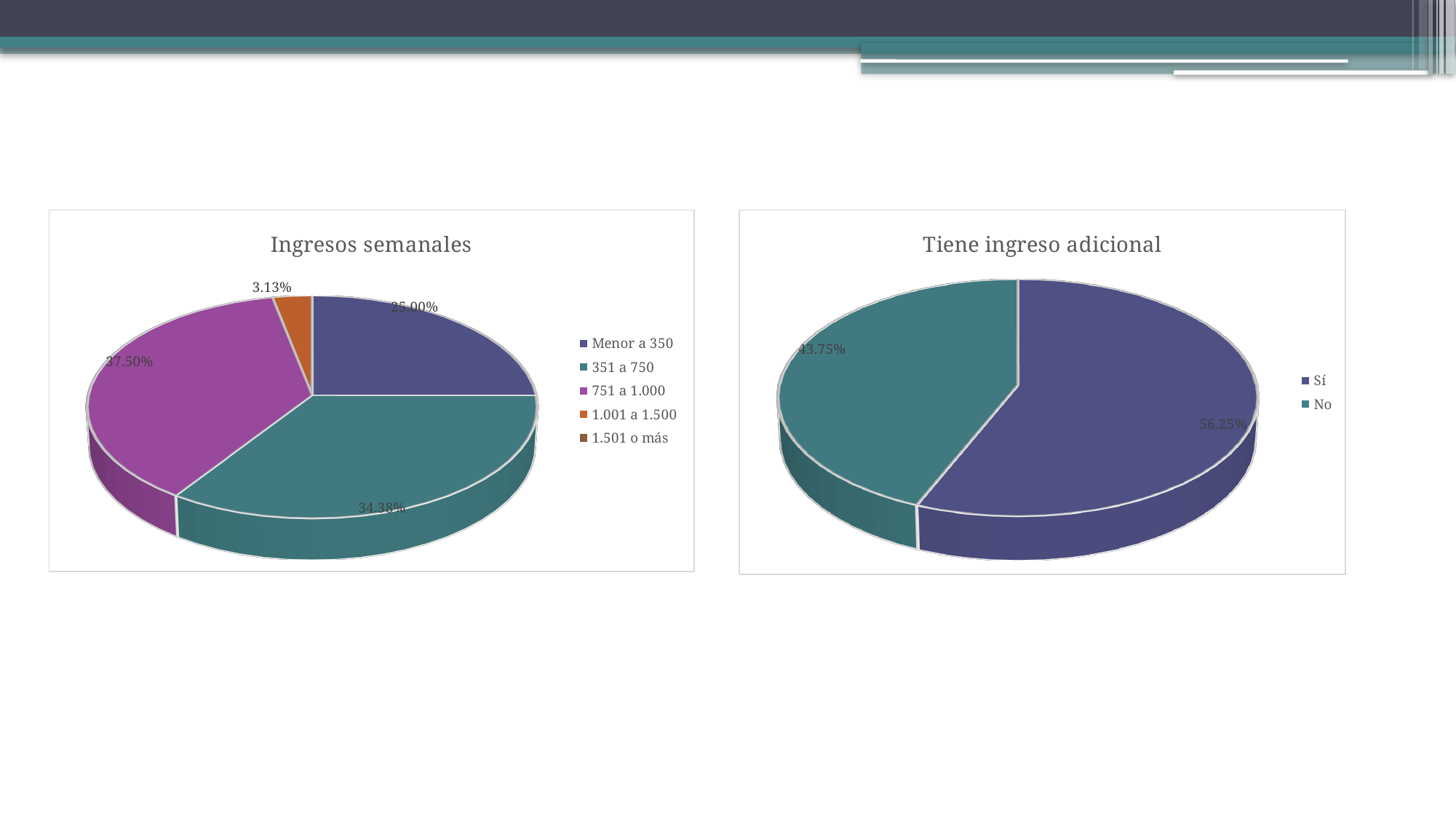
In the 'Ingresos semanales' chart, what is the difference between the '751 a 1.000' share and the 'Menor a 350' share? 12.50% In the 'Tiene ingreso adicional' chart, what share is labelled for 'No'? 43.75% In the 'Tiene ingreso adicional' chart, which is larger, 'Sí' or 'No'? Sí In the 'Ingresos semanales' chart, which category has the largest slice? 751 a 1.000 What kind of chart is the 'Tiene ingreso adicional' chart? Pie chart In the 'Ingresos semanales' chart, what share is labelled for the '1.001 a 1.500' slice? 3.13% In the 'Ingresos semanales' chart, what share is labelled for the '351 a 750' slice? 34.38% In the 'Ingresos semanales' chart, what share is labelled for the 'Menor a 350' slice? 25.00% In the 'Ingresos semanales' chart, what share is labelled for the '751 a 1.000' slice? 37.50% In the 'Tiene ingreso adicional' chart, what share is labelled for 'Sí'? 56.25% In the 'Ingresos semanales' chart, which labelled slice is the smallest? 1.001 a 1.500 In the 'Ingresos semanales' chart, how many categories does the legend list? 5